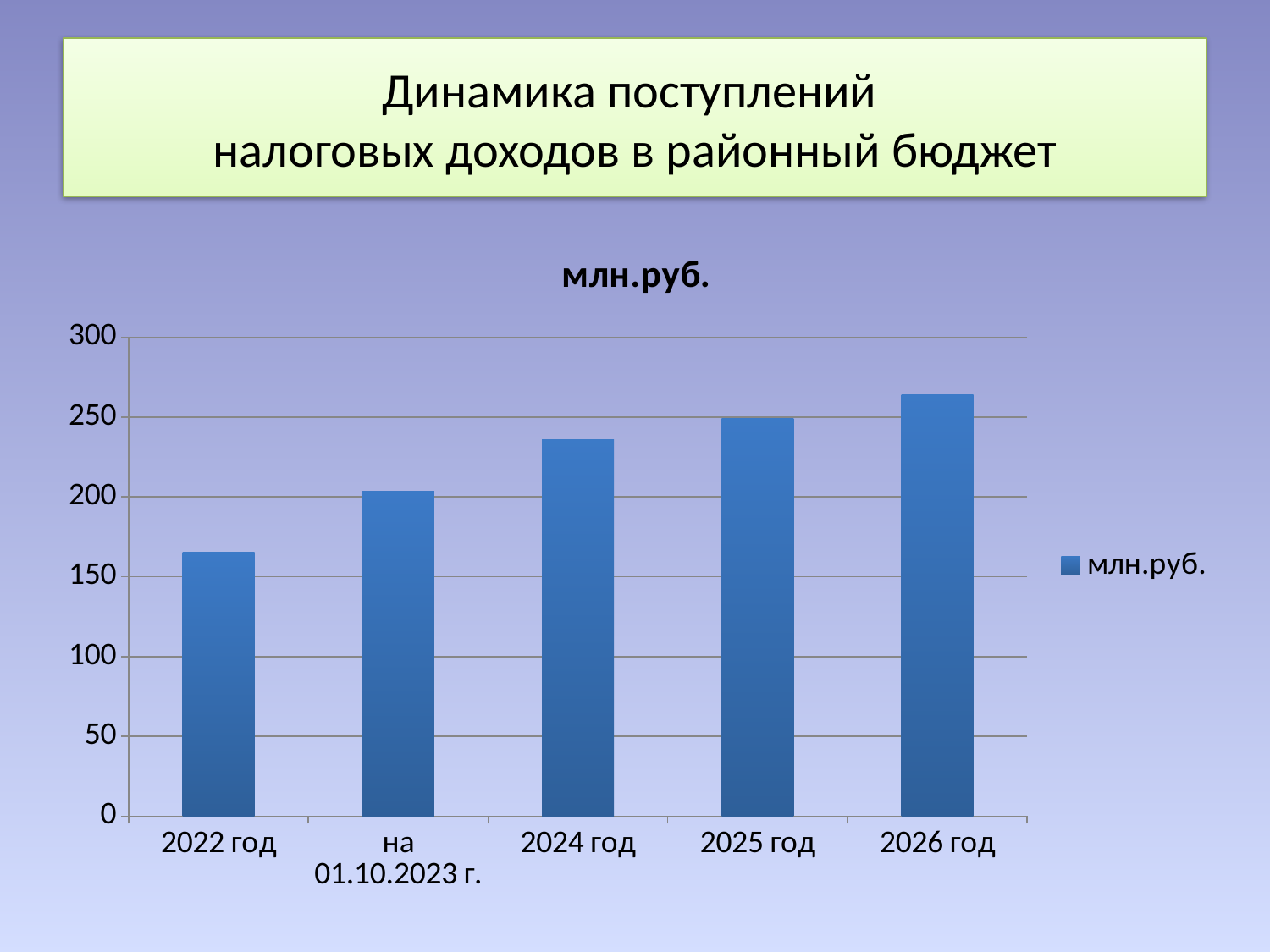
Is the value for 2022 год greater or less than 200? less Do the values rise or fall from 2022 год to 2026 год? rise What kind of chart is shown on the slide? bar chart Which is larger, the value for 2024 год or the value for 2022 год? 2024 год Is the value for 2024 год greater or less than 250? less What is the title shown above the chart? млн.руб. How many series does the legend list? 1 Is the value for 2022 год greater or less than 150? greater Which category has the lowest value? 2022 год Which category has the highest value? 2026 год How many categories are plotted along the x axis? 5